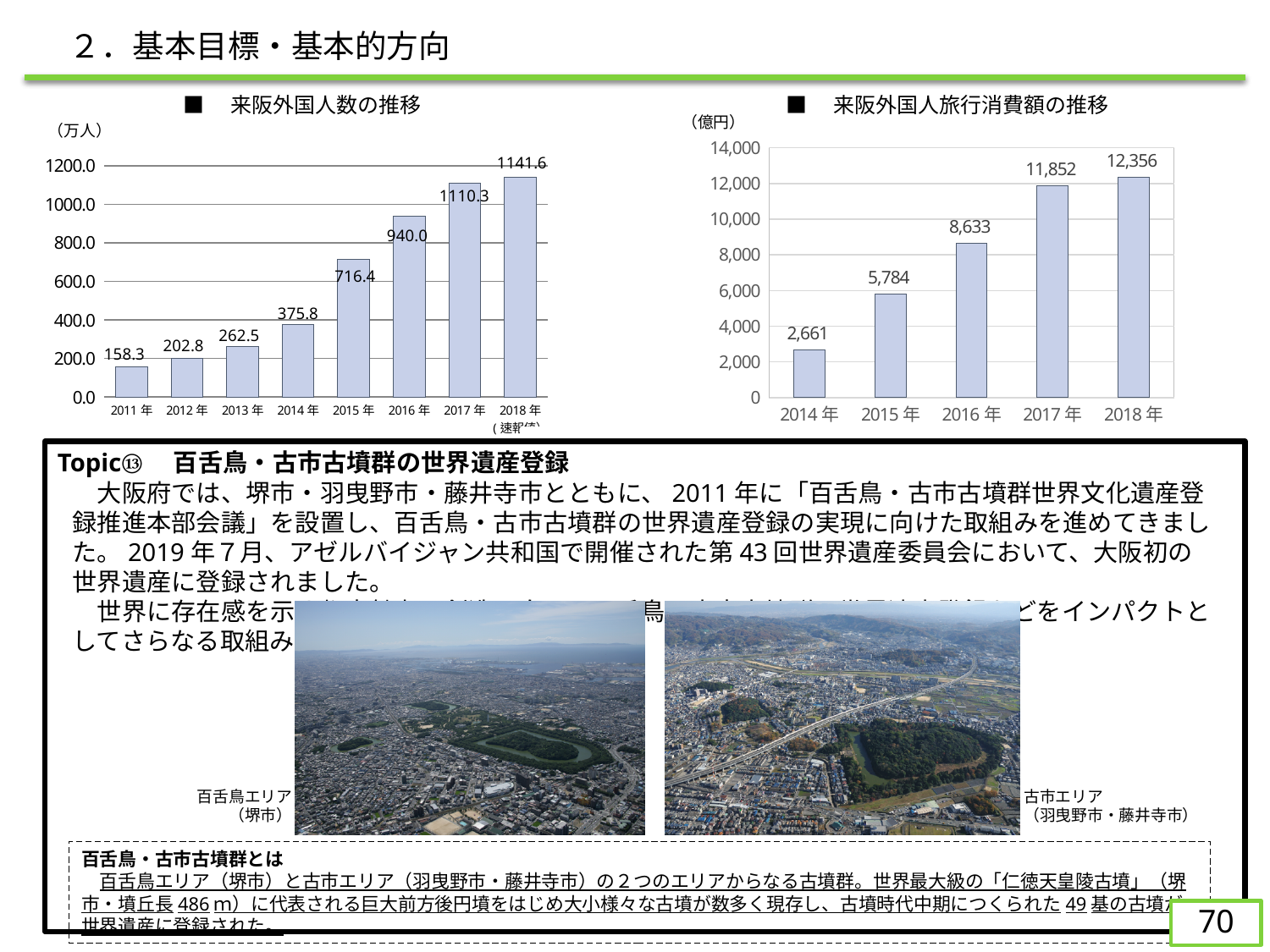
In the left chart (来阪外国人数の推移), how many years are plotted? 8 In the right chart (来阪外国人旅行消費額の推移), how many years are plotted? 5 In the left chart (来阪外国人数の推移), which year has the highest value? 2018年 In the right chart (来阪外国人旅行消費額の推移), which is larger, the value for 2015年 or 2016年? 2016年 In the left chart (来阪外国人数の推移), do the values rise or fall from 2011年 to 2018年? rise What type of chart is the right chart (来阪外国人旅行消費額の推移)? bar chart In the right chart (来阪外国人旅行消費額の推移), what is the value for 2016年? 8,633 In the right chart (来阪外国人旅行消費額の推移), what is the difference between the 2018年 and 2017年 values? 504 In the left chart (来阪外国人数の推移), what is the difference between the 2017年 and 2016年 values? 170.3 In the left chart (来阪外国人数の推移), what is the value for 2015年? 716.4 In the left chart (来阪外国人数の推移), what is the value for 2011年? 158.3 In the right chart (来阪外国人旅行消費額の推移), which year has the lowest value? 2014年